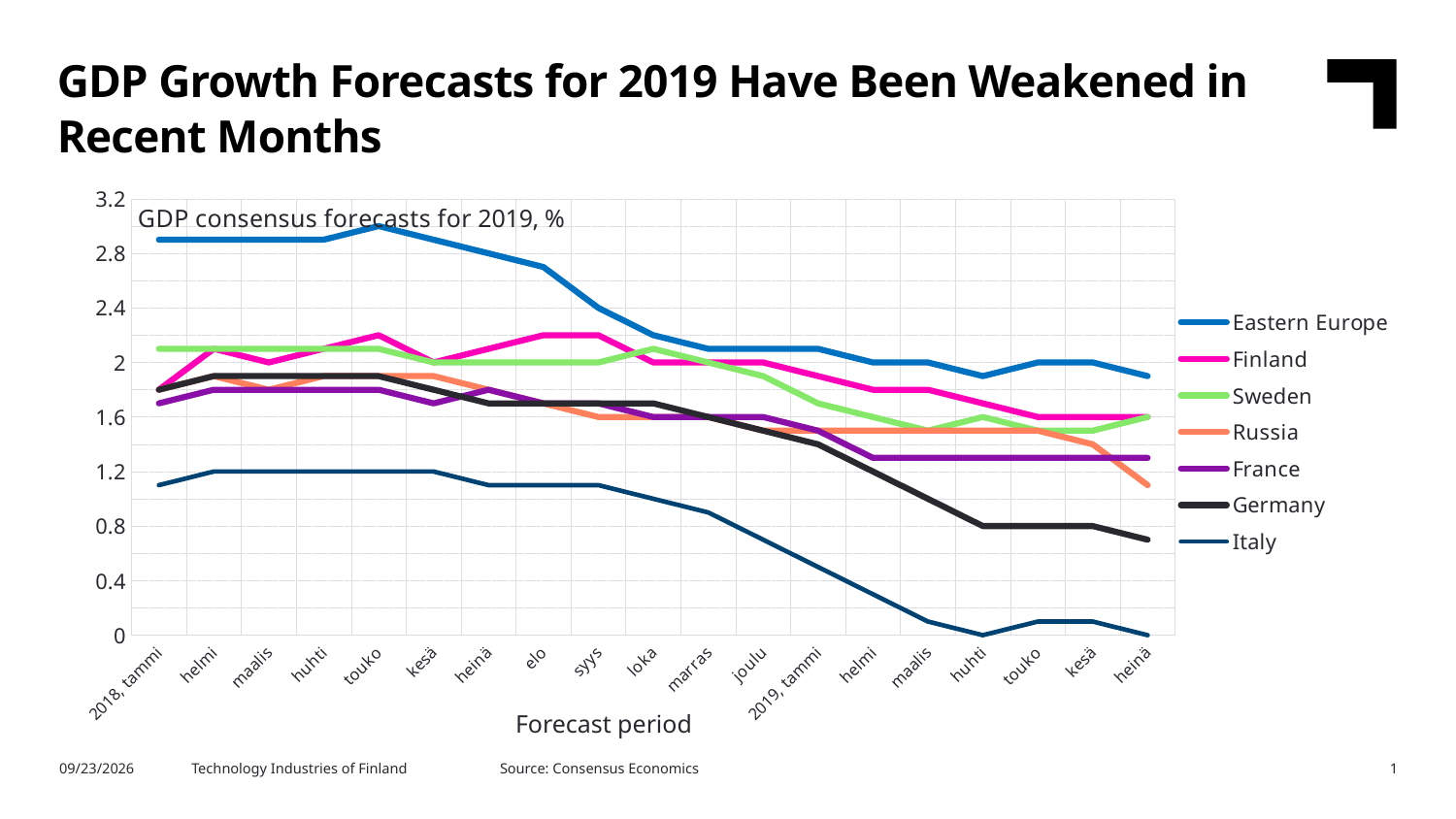
How many forecast periods are shown along the x axis? 19 Is the value for Russia at 2019 heinä greater or less than 1.2? less Is the value for Eastern Europe at 2018 touko greater or less than 2.8? greater Does the Italy series rise or fall from 2018, tammi to 2019 heinä? fall What kind of chart is shown on the slide? line chart How many series does the legend list? 7 Which series has the highest value at 2018, tammi? Eastern Europe Is the value for Germany at 2019 heinä greater or less than 0.8? less Which series has the lowest value at 2019 heinä? Italy What is the title shown inside the chart area? GDP consensus forecasts for 2019, % At 2019 maalis, which is larger: the value for Finland or the value for Germany? Finland What is the title of the x axis? Forecast period